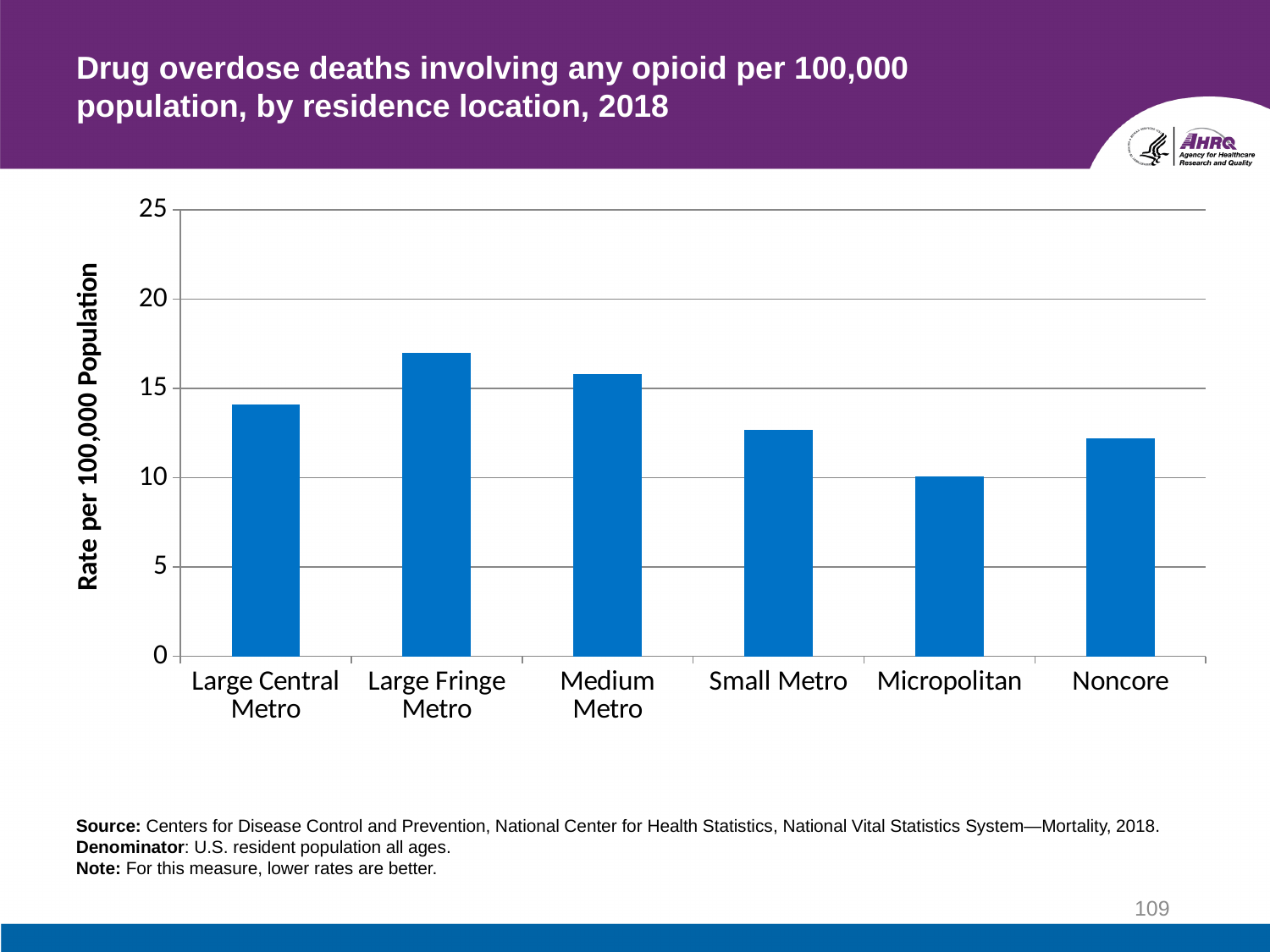
Is the value for Medium Metro greater or less than 15? greater Is the value for Large Central Metro greater or less than 15? less Is the value for Noncore greater or less than 15? less Which residence location has the lowest rate of drug overdose deaths involving any opioid? Micropolitan Which has a higher rate, Large Fringe Metro or Medium Metro? Large Fringe Metro Which residence location has the highest rate of drug overdose deaths involving any opioid? Large Fringe Metro How many residence location categories are shown on the x axis? 6 Which has a higher rate, Large Central Metro or Small Metro? Large Central Metro What is the label of the y axis? Rate per 100,000 Population What kind of chart is shown on the slide? bar chart